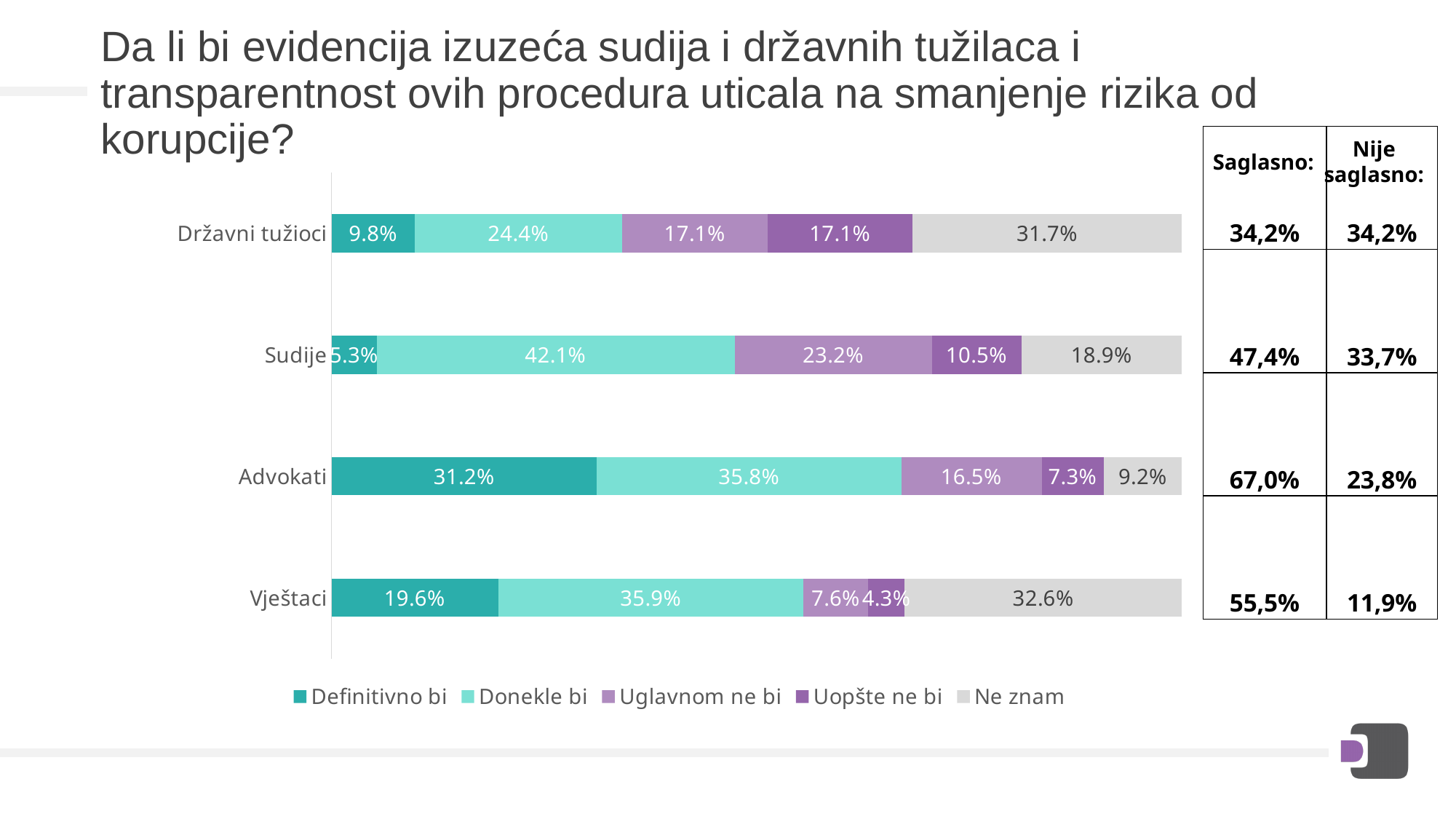
Which legend entry is shown in grey? Ne znam Which category has the highest value for "Definitivno bi"? Advokati What kind of chart is shown on the slide? Stacked bar chart What is the value of "Uopšte ne bi" for Državni tužioci? 17.1% How many series does the legend list? 5 What is the difference between the "Definitivno bi" values for Advokati and Sudije? 25.9 percentage points Which category has the lowest value for "Ne znam"? Advokati How many categories are shown on the chart? 4 What is the value of "Uglavnom ne bi" for Advokati? 16.5% Which is larger: the "Donekle bi" value for Državni tužioci or for Vještaci? Vještaci What is the value of "Ne znam" for Vještaci? 32.6% What is the value of "Donekle bi" for Sudije? 42.1%